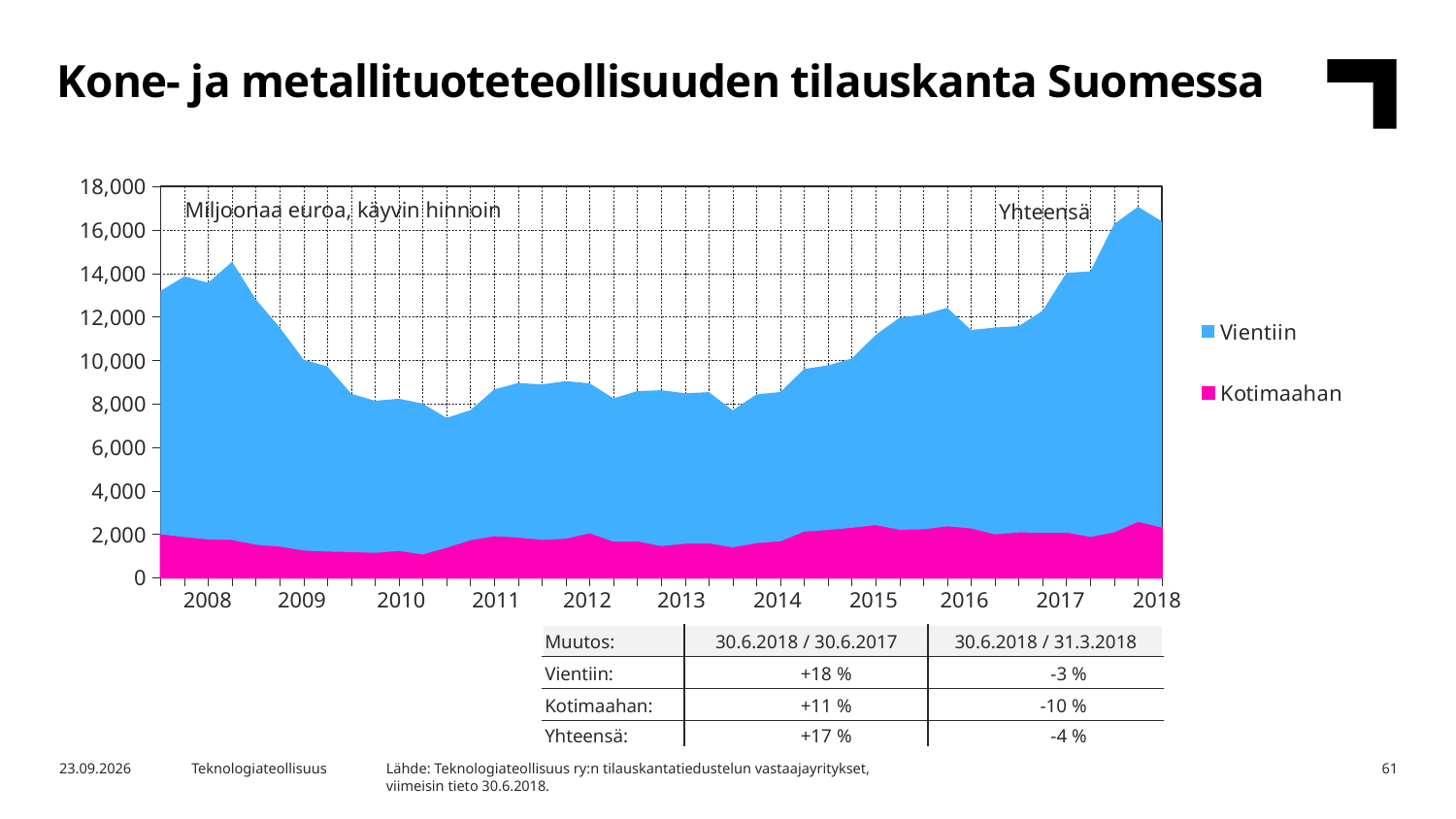
What is the title of the slide containing the chart? Kone- ja metallituoteteollisuuden tilauskanta Suomessa Is the total order backlog (Yhteensä) at the 2018 end of the chart greater or less than 16,000? greater What are the two series named in the chart legend? Vientiin and Kotimaahan How many series does the chart legend list? 2 Does the total order backlog rise or fall between 2008 and 2010? Fall Is the Kotimaahan value at 2018 greater or less than 4,000? less In which year shown on the x axis does the total order backlog reach its highest level? 2018 Is the total order backlog (Yhteensä) at the start of 2008 greater or less than 12,000? greater Which series is larger throughout the chart, Vientiin or Kotimaahan? Vientiin How many year labels are shown on the x axis of the chart? 11 Does the total order backlog rise or fall between 2016 and 2018? Rise What kind of chart is shown on the slide? Stacked area chart